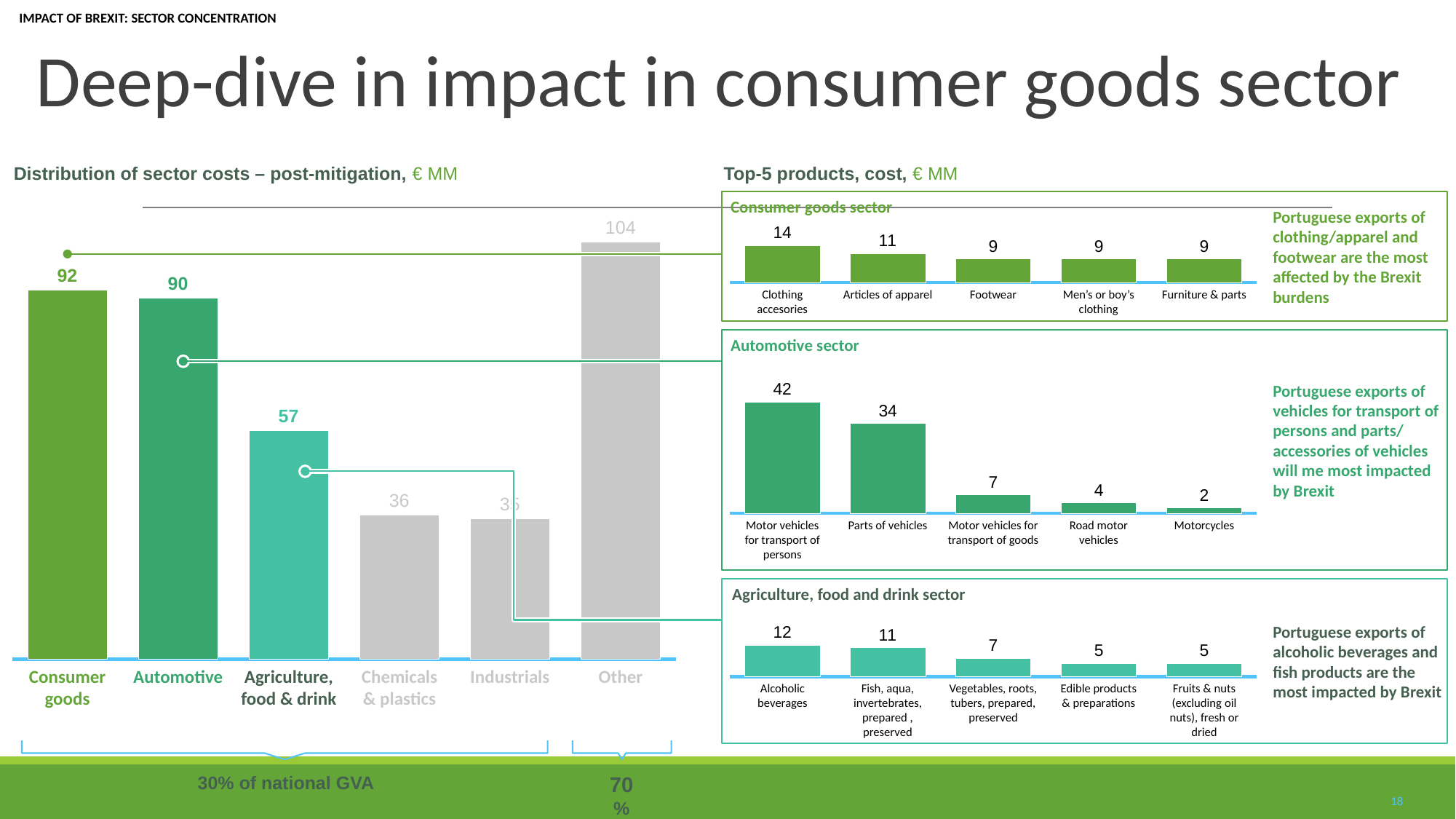
In the 'Automotive sector' chart, what is the value for Parts of vehicles? 34 In the 'Distribution of sector costs – post-mitigation' chart, what is the value for Consumer goods? 92 In the 'Distribution of sector costs – post-mitigation' chart, which sector has the highest value? Other In the 'Distribution of sector costs – post-mitigation' chart, what is the difference between the Automotive and Agriculture, food & drink values? 33 In the 'Consumer goods sector' chart, what is the value for Clothing accesories? 14 In the 'Agriculture, food and drink sector' chart, what is the value for Edible products & preparations? 5 In the 'Agriculture, food and drink sector' chart, which is larger: Alcoholic beverages or Vegetables, roots, tubers, prepared, preserved? Alcoholic beverages In the 'Distribution of sector costs – post-mitigation' chart, how many sectors are shown? 6 In the 'Automotive sector' chart, what is the difference between Motor vehicles for transport of persons and Parts of vehicles? 8 In the 'Automotive sector' chart, which product has the lowest value? Motorcycles In the 'Consumer goods sector' chart, which product has the highest value? Clothing accesories What kind of chart is the 'Distribution of sector costs – post-mitigation' chart? Bar chart